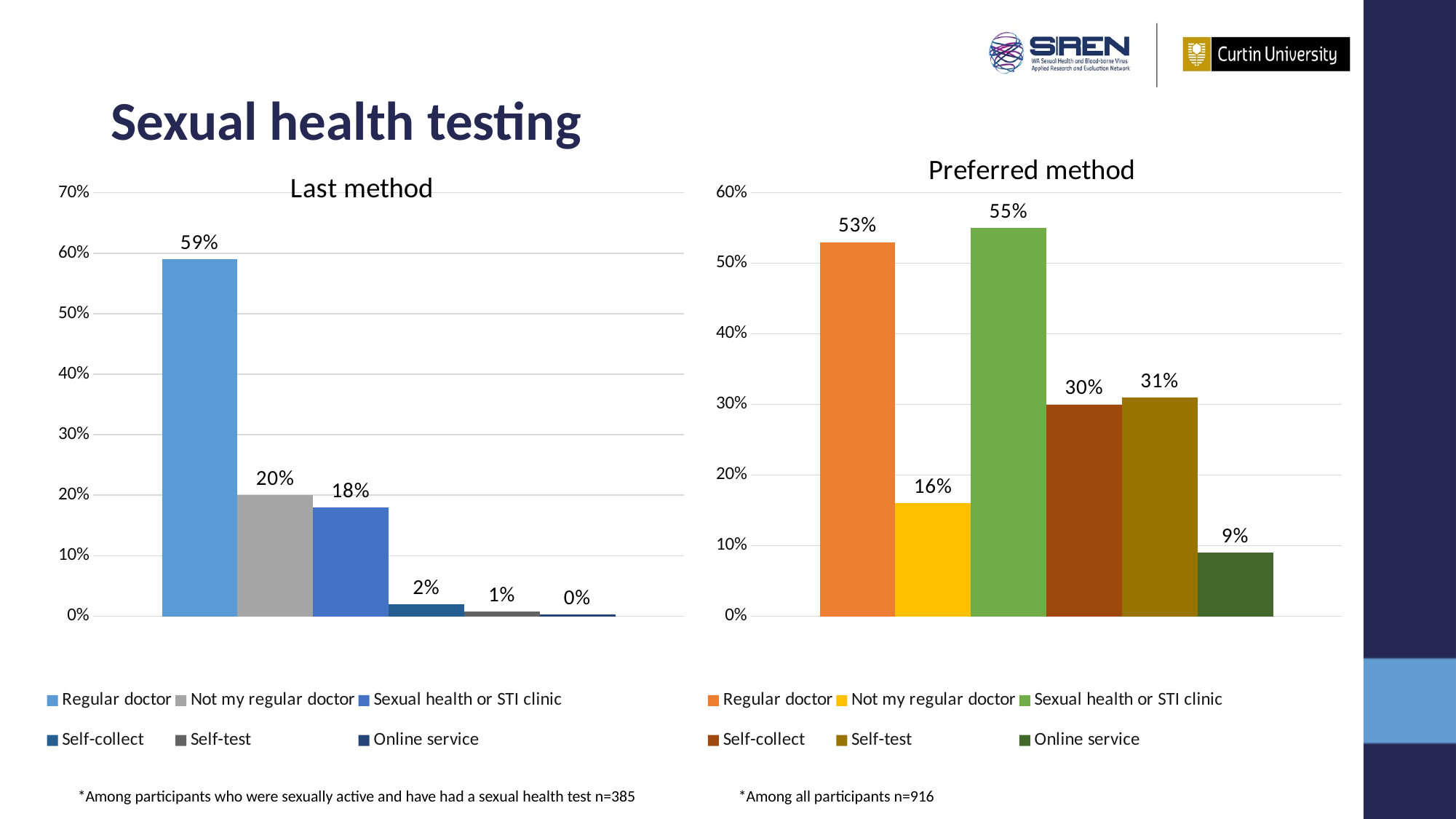
In the 'Preferred method' chart, which is larger: Not my regular doctor or Online service? Not my regular doctor In the 'Preferred method' chart, which category has the highest value? Sexual health or STI clinic In the 'Last method' chart, which category has the lowest value? Online service What kind of chart is the 'Preferred method' chart? Bar chart How many categories are plotted in the 'Preferred method' chart? 6 In the 'Last method' chart, is the value for Sexual health or STI clinic greater or less than 10%? greater What is the title of the chart on the left of the slide? Last method In the 'Preferred method' chart, what is the value for Self-test? 31% How many entries does the legend of the 'Last method' chart list? 6 In the 'Last method' chart, what is the value for Regular doctor? 59% In the 'Preferred method' chart, what is the difference between Sexual health or STI clinic and Self-collect? 25% In the 'Last method' chart, what is the difference between Regular doctor and Not my regular doctor? 39%